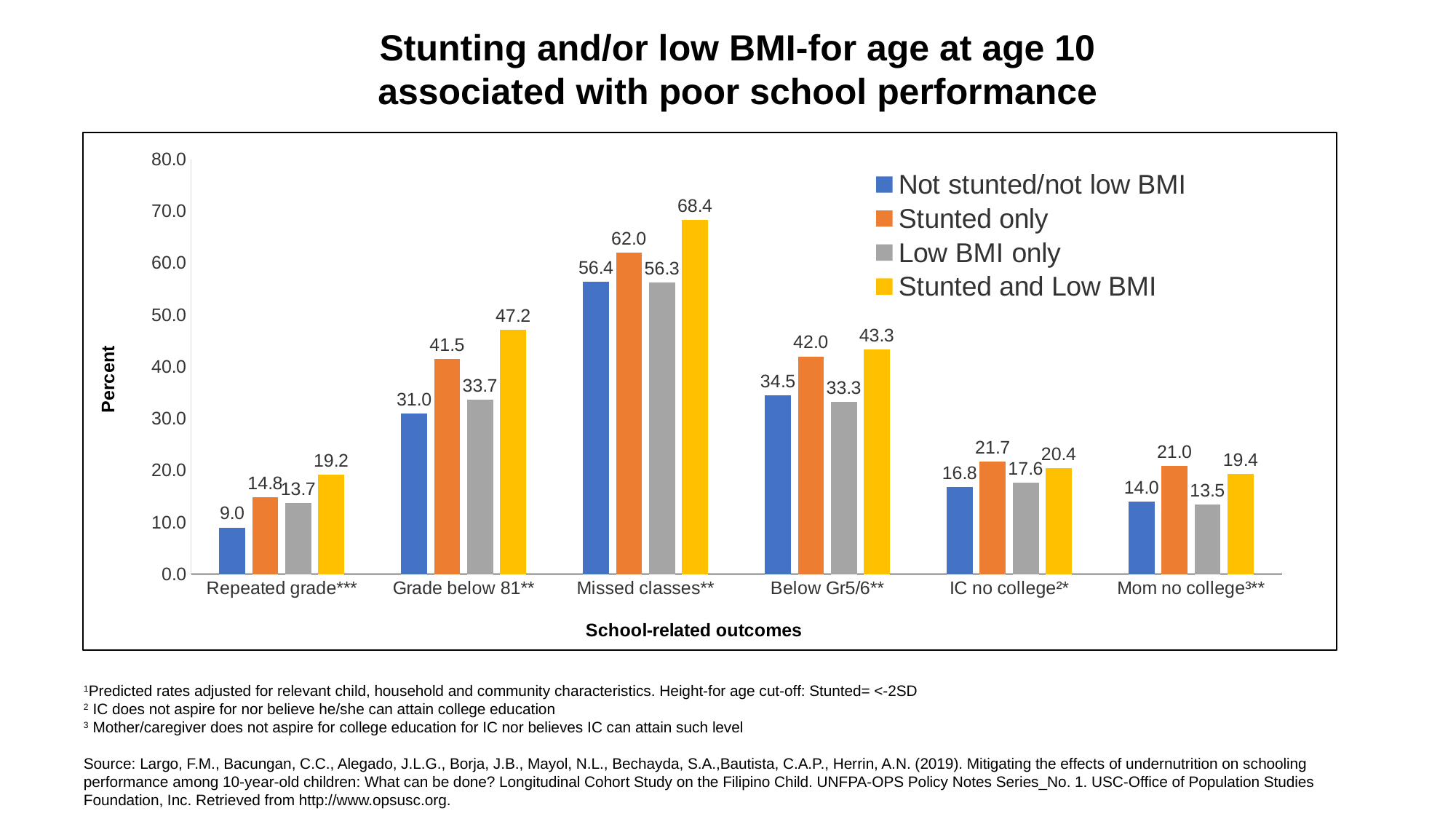
What is the value for Stunted and Low BMI in the Missed classes** category? 68.4 What kind of chart is shown on the slide? Bar chart What is the label of the y axis? Percent In the Below Gr5/6** category, which is larger: the Stunted only value or the Low BMI only value? Stunted only Which category has the lowest value for the Not stunted/not low BMI series? Repeated grade*** What colour represents the Stunted and Low BMI series? Yellow How many categories are shown on the x axis? 6 How many series does the legend list? 4 What is the value for Low BMI only in the Grade below 81** category? 33.7 What is the value for Not stunted/not low BMI in the Repeated grade*** category? 9.0 What is the difference between the Stunted and Low BMI value and the Not stunted/not low BMI value in the Grade below 81** category? 16.2 Which category has the highest value for the Stunted only series? Missed classes**